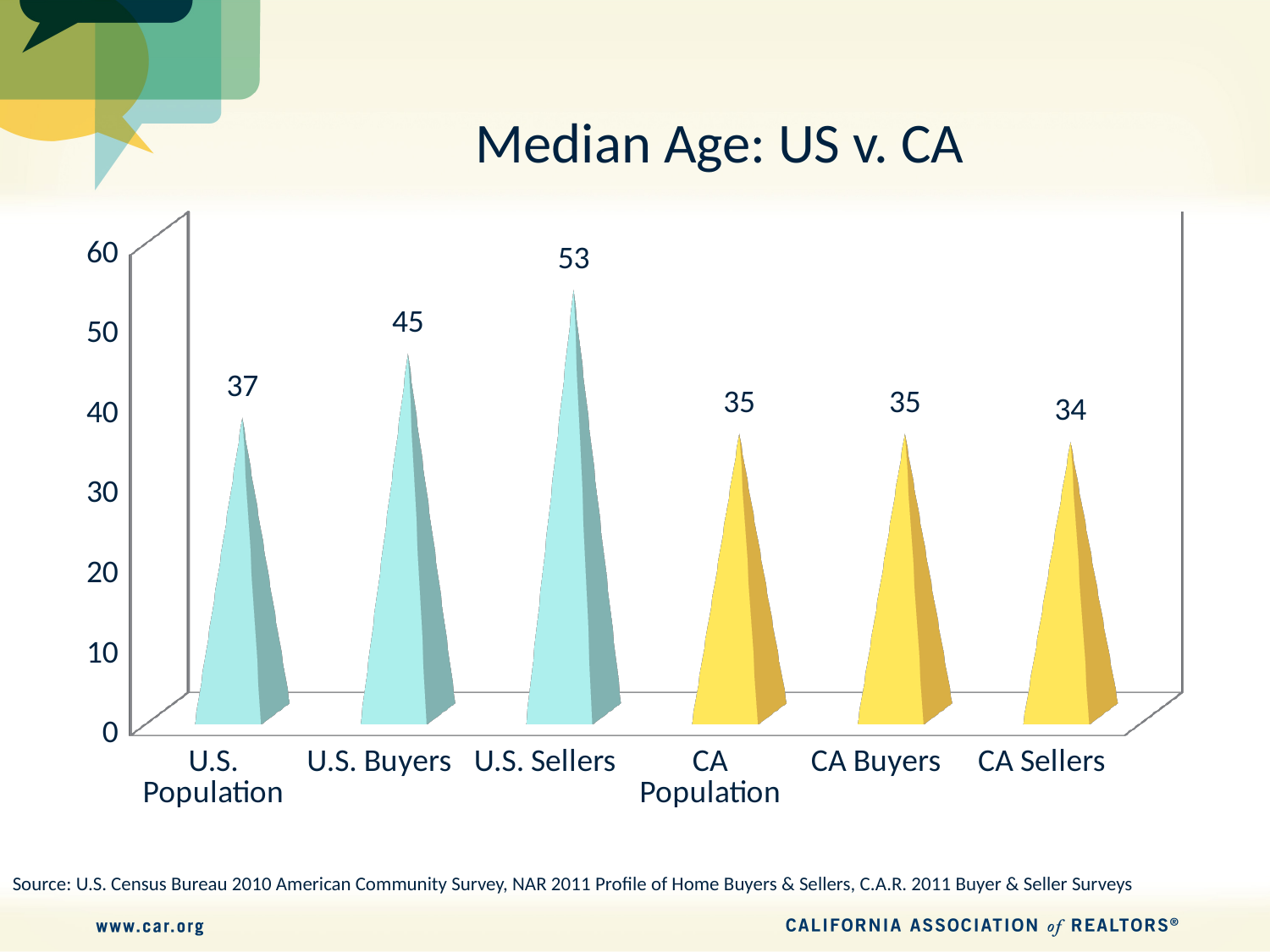
What is the title of the chart? Median Age: US v. CA What is the difference in median age between U.S. Buyers and CA Buyers? 10 What is the median age for U.S. Sellers? 53 Which is larger, the median age of the U.S. Population or the CA Population? U.S. Population Which category has the lowest median age? CA Sellers How many categories are shown on the chart? 6 What is the difference in median age between U.S. Sellers and U.S. Buyers? 8 Which category has the highest median age? U.S. Sellers What kind of chart is shown on the slide? Bar chart What is the median age for CA Sellers? 34 What is the median age for the CA Population? 35 Is the median age for U.S. Sellers greater or less than 50? greater